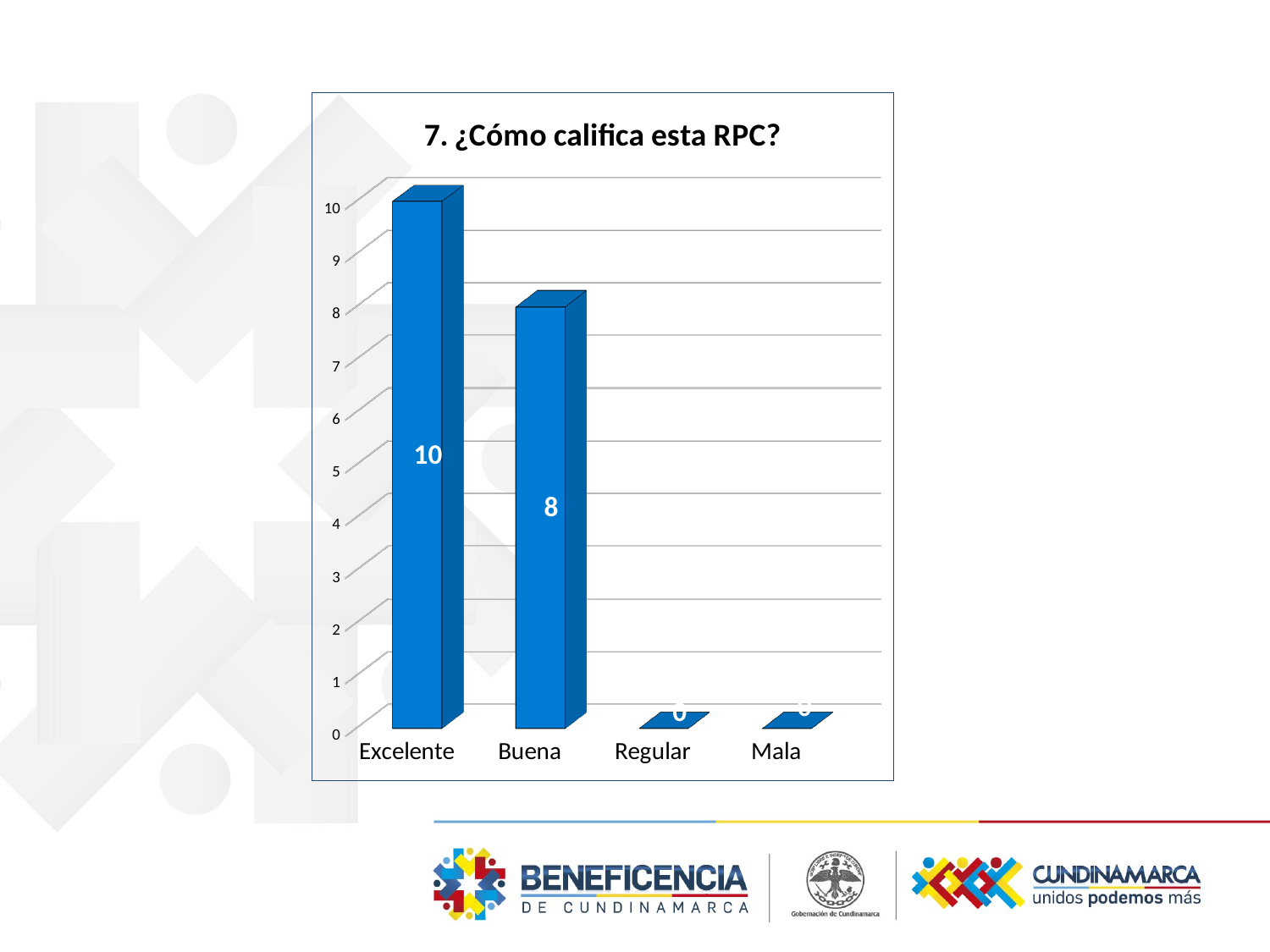
What is the title of the chart? 7. ¿Cómo califica esta RPC? Which category has the highest value? Excelente Do the values rise or fall from Excelente to Mala along the x axis? fall What kind of chart is shown on the slide? bar chart What is the value for Mala? 0 What is the difference between the values for Excelente and Buena? 2 Is the value for Buena greater or less than 5? greater How many categories are shown on the x axis? 4 What is the value for Excelente? 10 Which is larger, the value for Buena or the value for Regular? Buena What is the value for Regular? 0 What is the value for Buena? 8